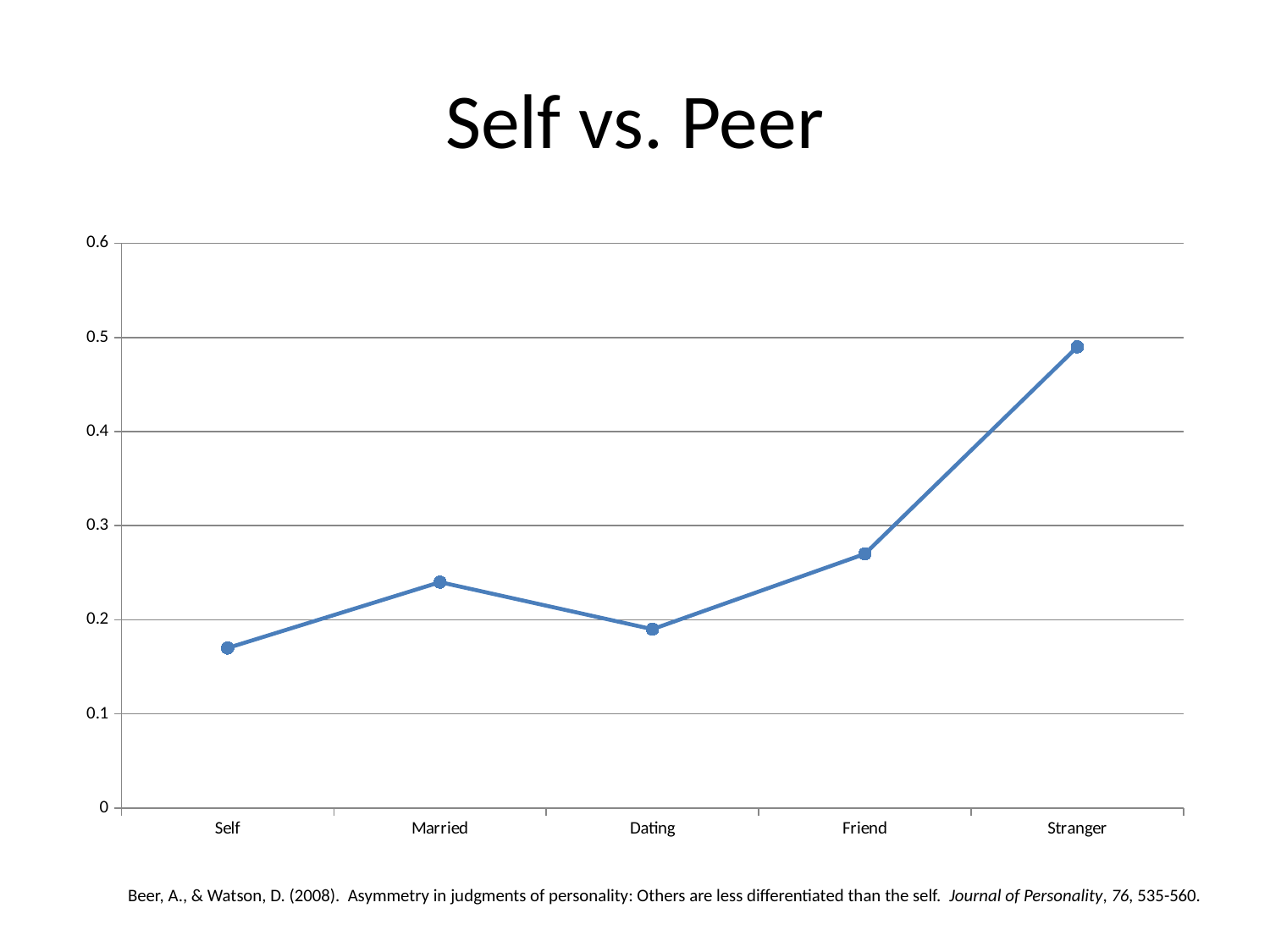
Is the value for Stranger greater or less than 0.4? greater Which is larger, the value for Self or the value for Married? Married Which is larger, the value for Friend or the value for Stranger? Stranger What kind of chart is shown on the slide? line chart What is the title of the slide? Self vs. Peer Which category has the highest value? Stranger Is the value for Friend greater or less than 0.3? less Does the line rise or fall from Married to Dating? fall How many categories are plotted along the x axis? 5 Is the value for Self greater or less than 0.2? less Does the line rise or fall from Friend to Stranger? rise